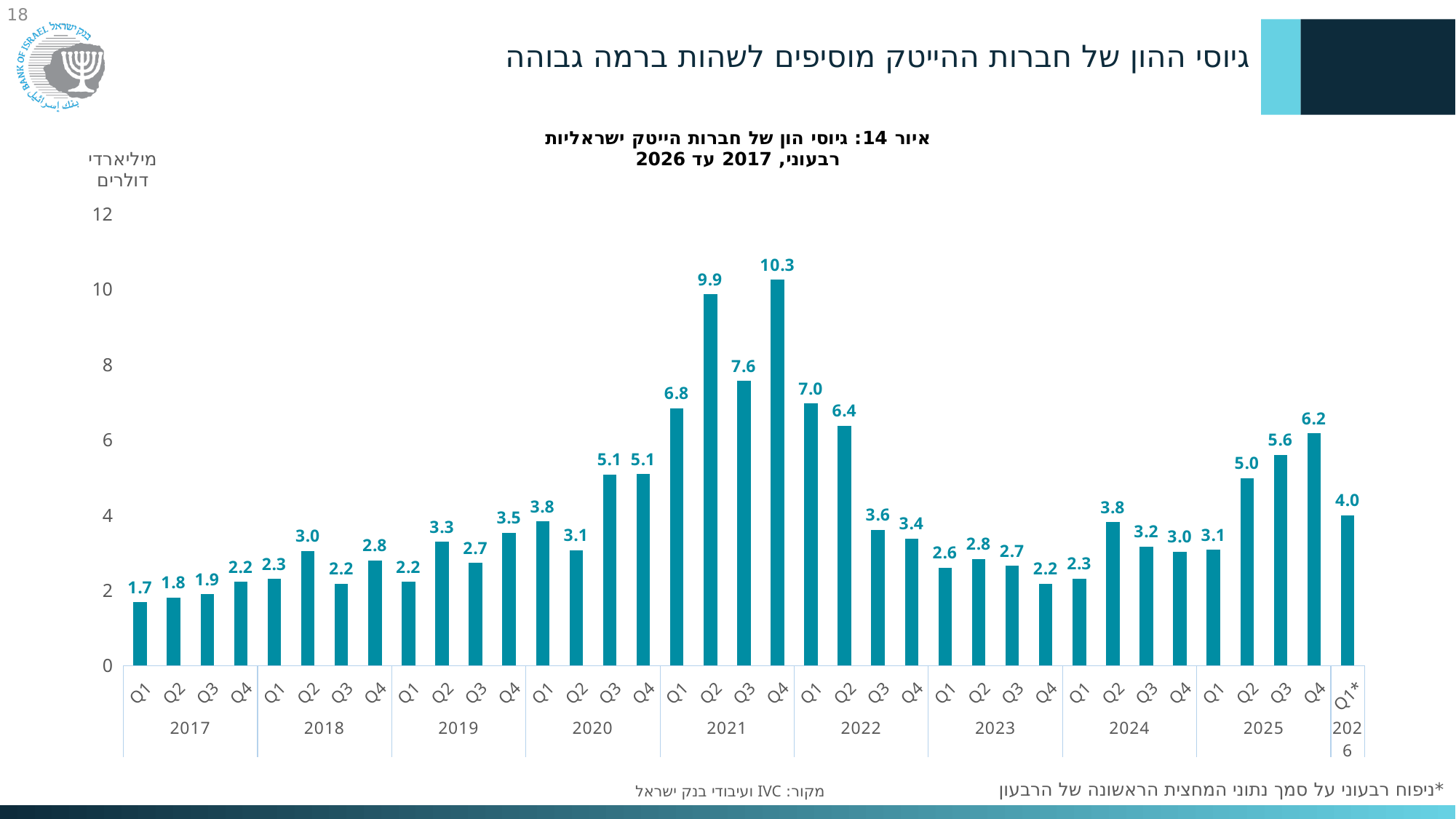
What is the value for Q1 2017? 1.7 What is the difference between the values for Q2 2021 and Q3 2021? 2.3 Which quarter has the highest value? Q4 2021 Which quarter has the lowest value? Q1 2017 What is the value for Q4 2021? 10.3 Do the values rise or fall from Q1 2025 to Q4 2025? Rise How many bars are plotted in the chart? 37 Which is larger, the value for Q2 2025 or the value for Q3 2025? Q3 2025 What kind of chart is shown on the slide? Bar chart Is the value for Q1 2021 greater or less than 6? greater What is the value for Q1* 2026? 4.0 What is the value for Q4 2025? 6.2